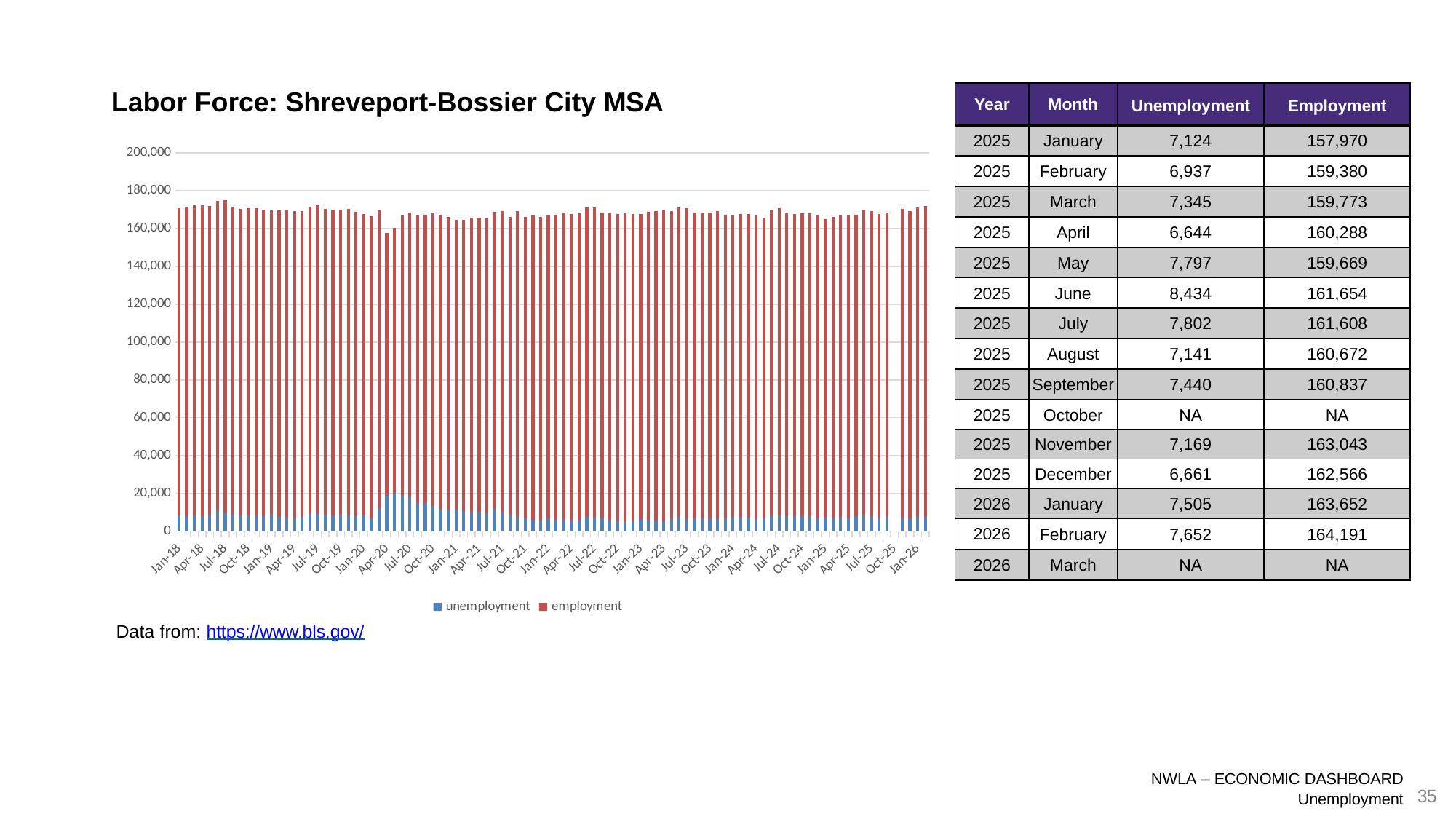
What is the total labor force (unemployment plus employment) for February 2026 based on the table values? 171,843 Which month in the table has the highest unemployment value? June 2025 According to the table, what was employment in the Shreveport-Bossier City MSA in February 2026? 164,191 Is the total stacked bar for Apr-20 greater or less than 170,000? less By how much did employment increase from January 2026 to February 2026 according to the table? 539 Which month in the table has the lowest employment value? January 2025 What are the two series named in the chart legend? unemployment and employment What is the title of the chart? Labor Force: Shreveport-Bossier City MSA What is the highest value shown on the chart's vertical axis? 200,000 According to the table, what was unemployment in June 2025? 8,434 What kind of chart is shown on the slide? Stacked bar chart How many series does the chart legend list? 2